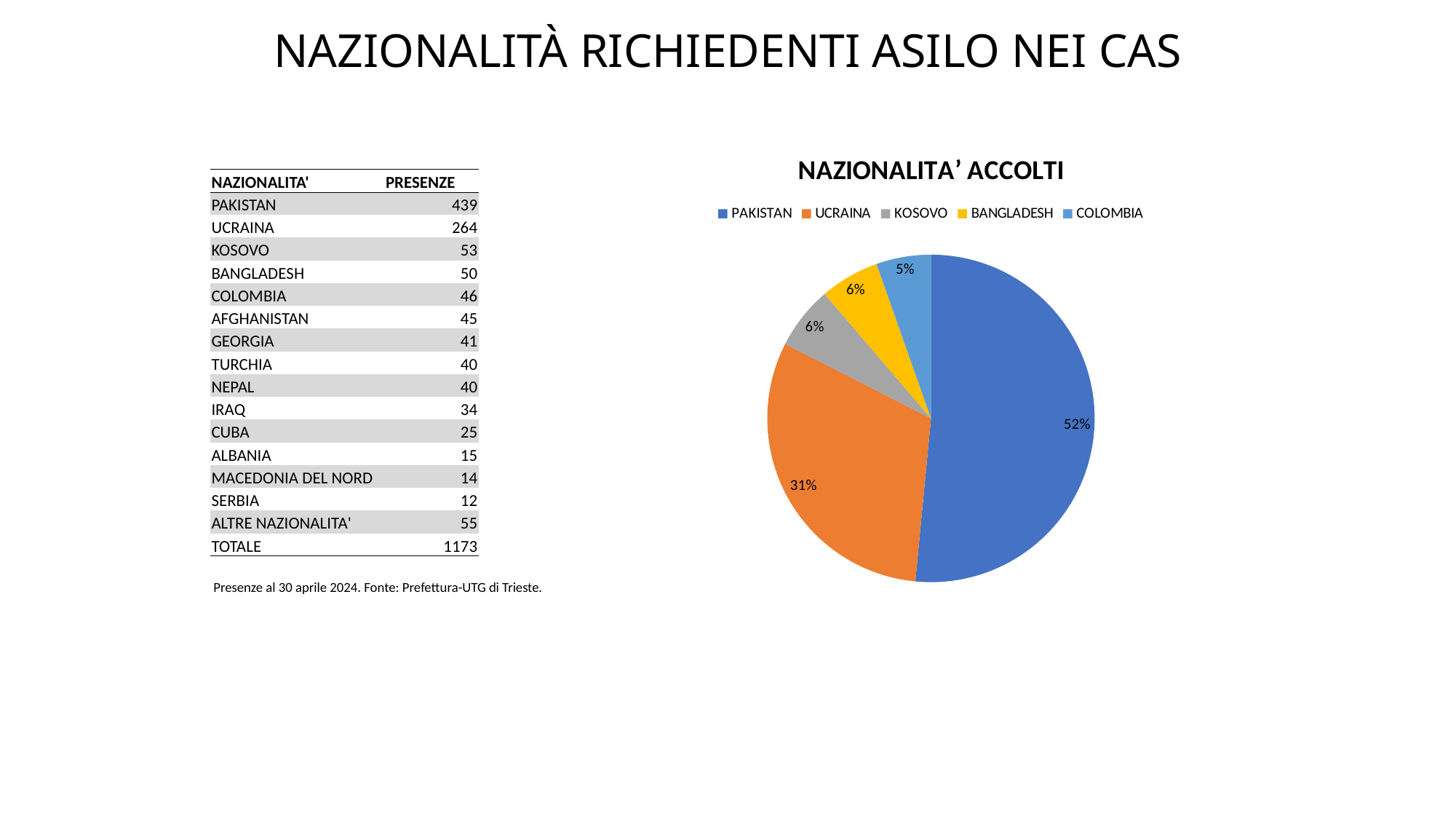
Which nationality has the smallest slice of the pie? COLOMBIA Which nationality has the largest slice of the pie? PAKISTAN What share of the pie does COLOMBIA represent? 5% How many entries does the chart legend list? 5 What share of the pie does KOSOVO represent? 6% What share of the pie does PAKISTAN represent? 52% What kind of chart is shown on the slide? pie chart What is the title of the chart? NAZIONALITA' ACCOLTI How many slices does the pie chart have? 5 What is the difference in percentage points between the PAKISTAN and UCRAINA slices? 21 Which slice is larger, UCRAINA or BANGLADESH? UCRAINA